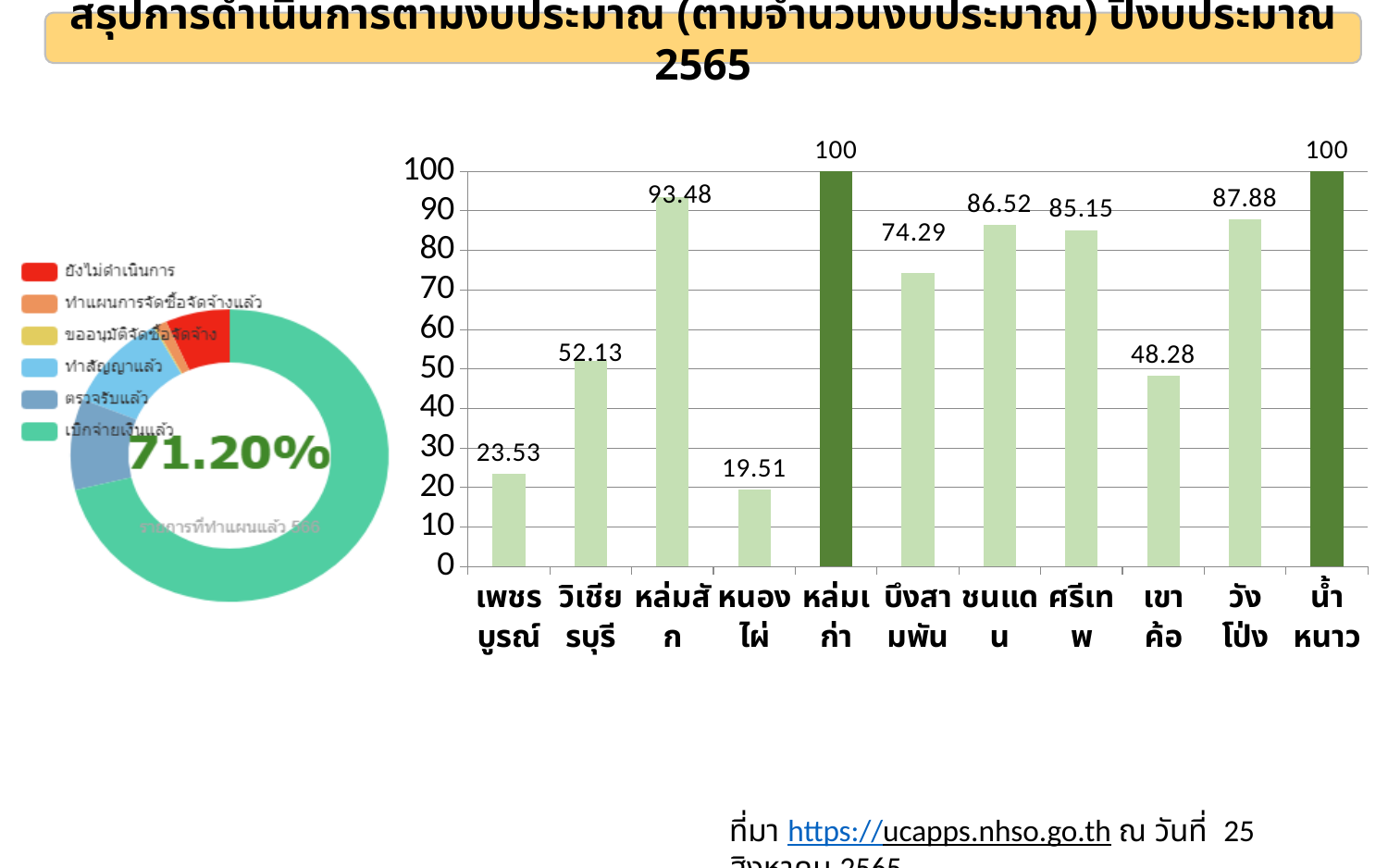
In the bar chart, what is the value for เขาค้อ? 48.28 In the bar chart, which category has the lowest value? หนองไผ่ In the bar chart, what is the difference between the values for ชนแดน and ศรีเทพ? 1.37 How many categories are shown on the x axis of the bar chart? 11 What percentage is shown in the centre of the donut chart on the left? 71.20% In the bar chart, which two categories both reach the highest value of 100? หล่มเก่า and น้ำหนาว In the bar chart, is the value for เพชรบูรณ์ greater or less than 30? less In the bar chart, what is the value for หนองไผ่? 19.51 In the bar chart, what is the value for บึงสามพัน? 74.29 In the bar chart, which is larger, the value for วิเชียรบุรี or the value for เขาค้อ? วิเชียรบุรี In the bar chart, what is the value for หล่มสัก? 93.48 What kind of chart is the chart on the right side of the slide? bar chart